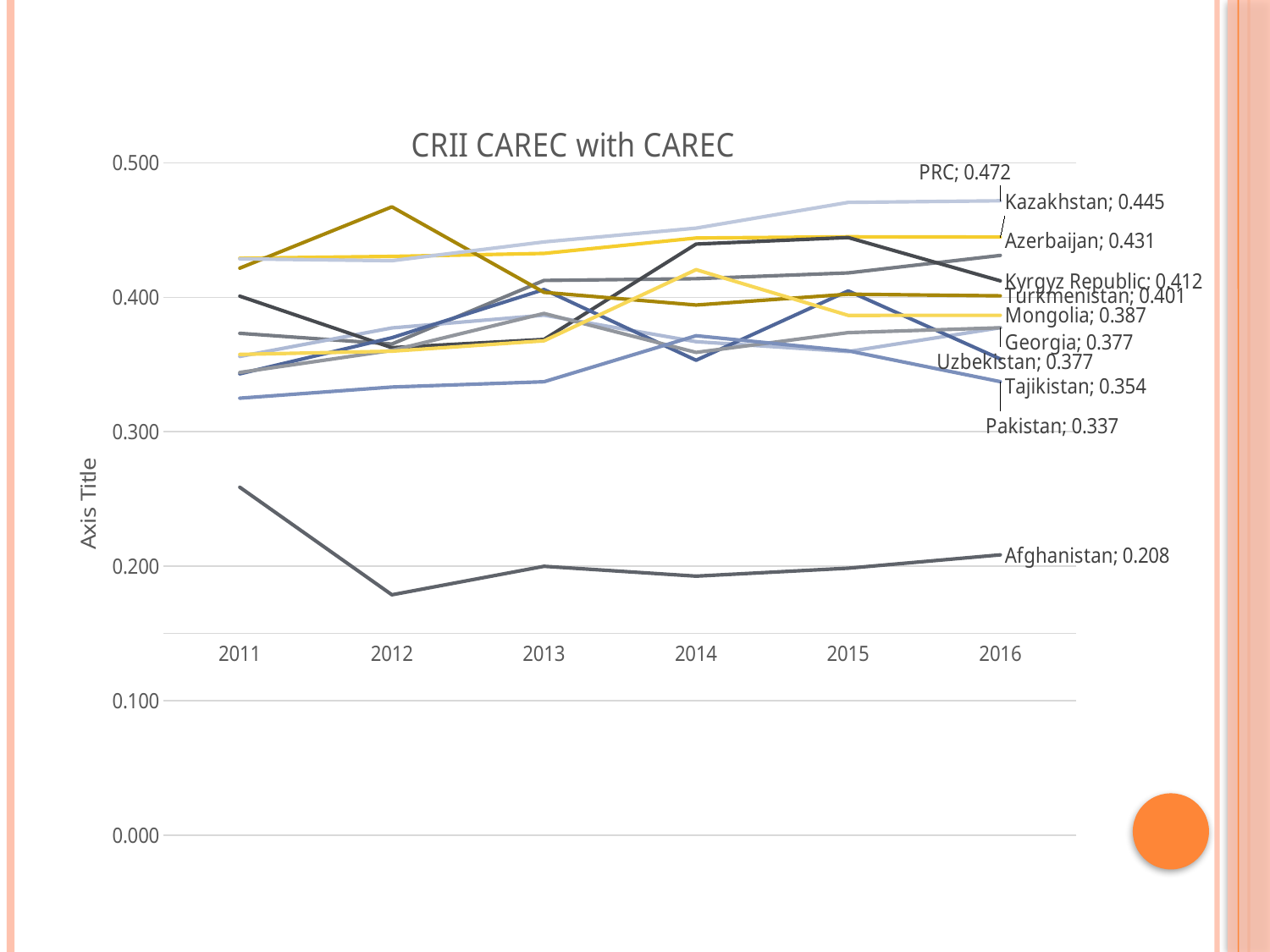
What is the value labelled for Kyrgyz Republic in 2016? 0.412 What is the title of the chart? CRII CAREC with CAREC Which country has the lowest labelled value in 2016? Afghanistan What is the value labelled for Pakistan in 2016? 0.337 Which has the larger 2016 value, Kazakhstan or Azerbaijan? Kazakhstan What is the value labelled for Afghanistan in 2016? 0.208 Is the value for Afghanistan in 2011 greater or less than 0.200? greater Which country has the highest labelled value in 2016? PRC What is the difference between the 2016 values for PRC and Afghanistan? 0.264 What kind of chart is shown on the slide? line chart How many years are shown on the x axis? 6 What is the value labelled for PRC in 2016? 0.472